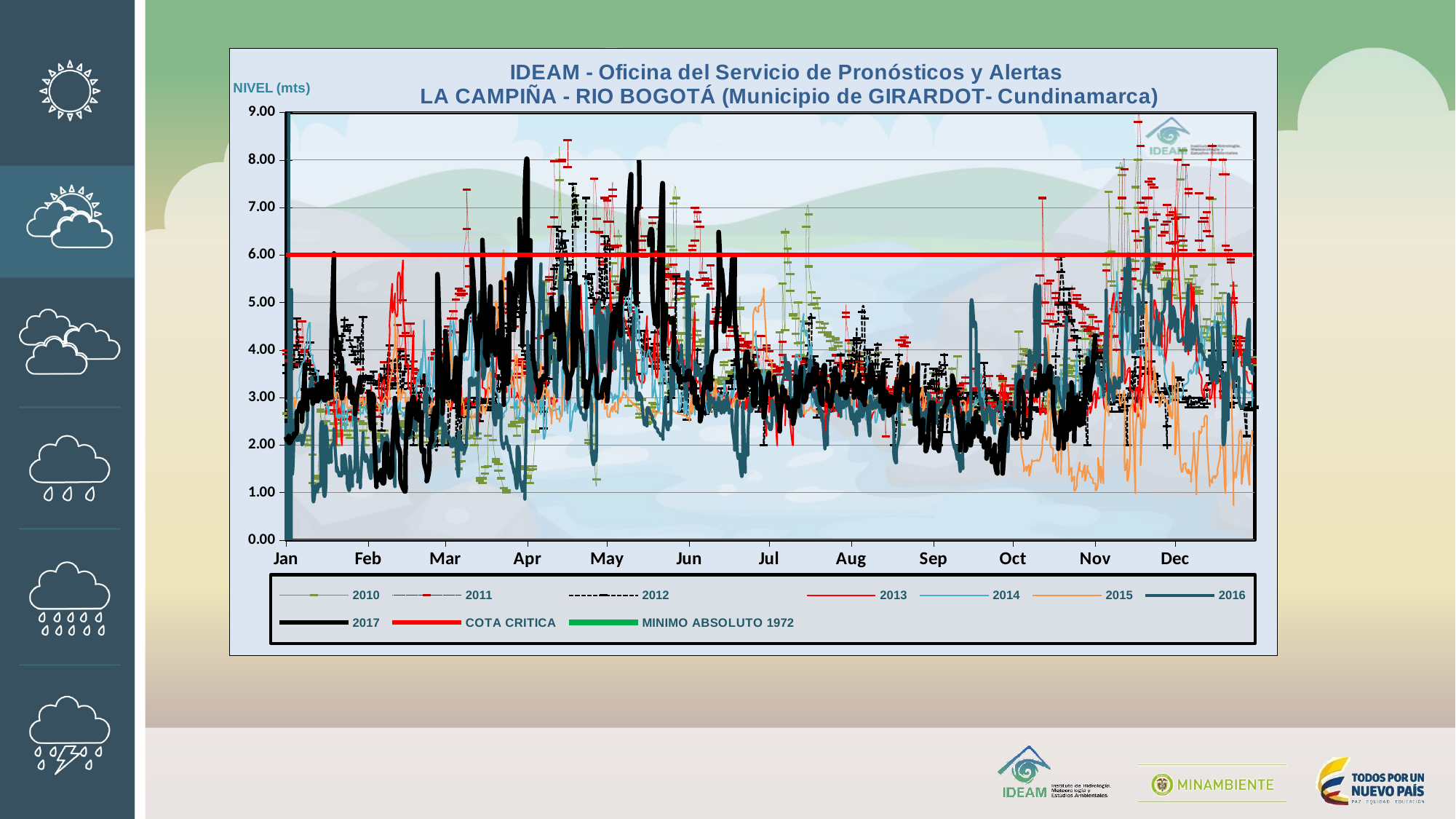
What is the highest value shown on the y axis? 9.00 Is the peak of the 2017 series (thick black line) around May greater or less than 7.00? greater How many months are labelled along the x axis? 12 Does the 2017 series rise above the COTA CRITICA line at any point during the year? Yes At what level (in mts) is the COTA CRITICA line drawn? 6.00 What kind of chart is shown on the slide? line chart What is the label of the y axis? NIVEL (mts) How many entries does the chart legend list? 10 Is the 2017 series during September greater or less than 4.00? less How many yearly series (2010 through 2017) are listed in the legend? 8